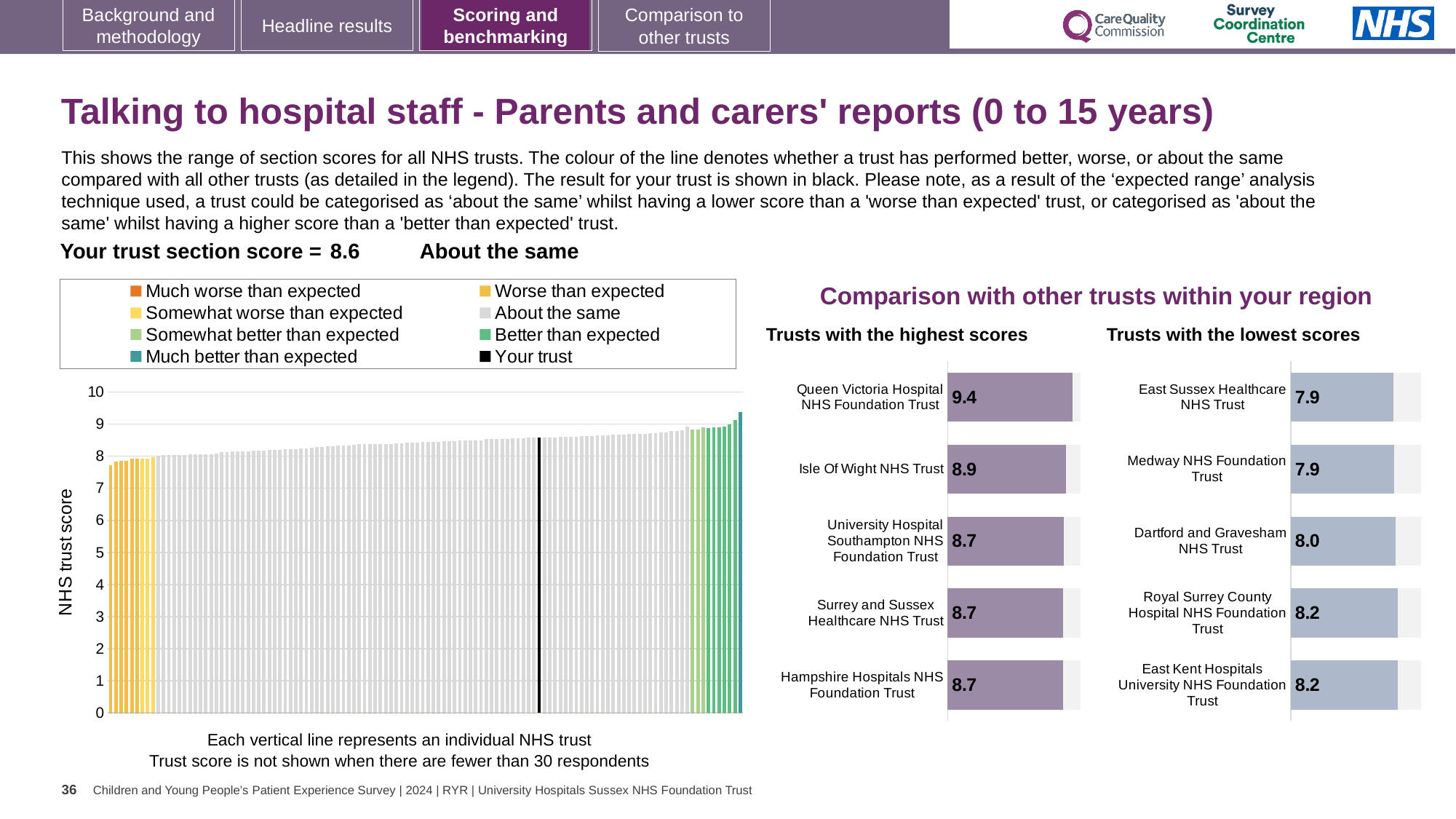
In the NHS trust score chart on the left, do the values rise or fall from left to right? Rise How many trusts are shown in the 'Trusts with the lowest scores' chart? 5 In the 'Trusts with the lowest scores' chart, which is larger: the score for Dartford and Gravesham NHS Trust or the score for Royal Surrey County Hospital NHS Foundation Trust? Royal Surrey County Hospital NHS Foundation Trust In the 'Trusts with the highest scores' chart, which trust has the highest score? Queen Victoria Hospital NHS Foundation Trust In the 'Trusts with the highest scores' chart, what is the difference between the scores of Queen Victoria Hospital NHS Foundation Trust and Isle Of Wight NHS Trust? 0.5 What is the section score for your trust shown on the NHS trust score chart? 8.6 In the 'Trusts with the lowest scores' chart, what is the score for Dartford and Gravesham NHS Trust? 8.0 In the 'Trusts with the highest scores' chart, what is the score for Isle Of Wight NHS Trust? 8.9 In the 'Trusts with the highest scores' chart, what is the score for Queen Victoria Hospital NHS Foundation Trust? 9.4 In the 'Trusts with the lowest scores' chart, what is the score for East Kent Hospitals University NHS Foundation Trust? 8.2 What kind of chart is the NHS trust score chart on the left of the slide? Bar chart How many entries does the legend of the NHS trust score chart list? 8